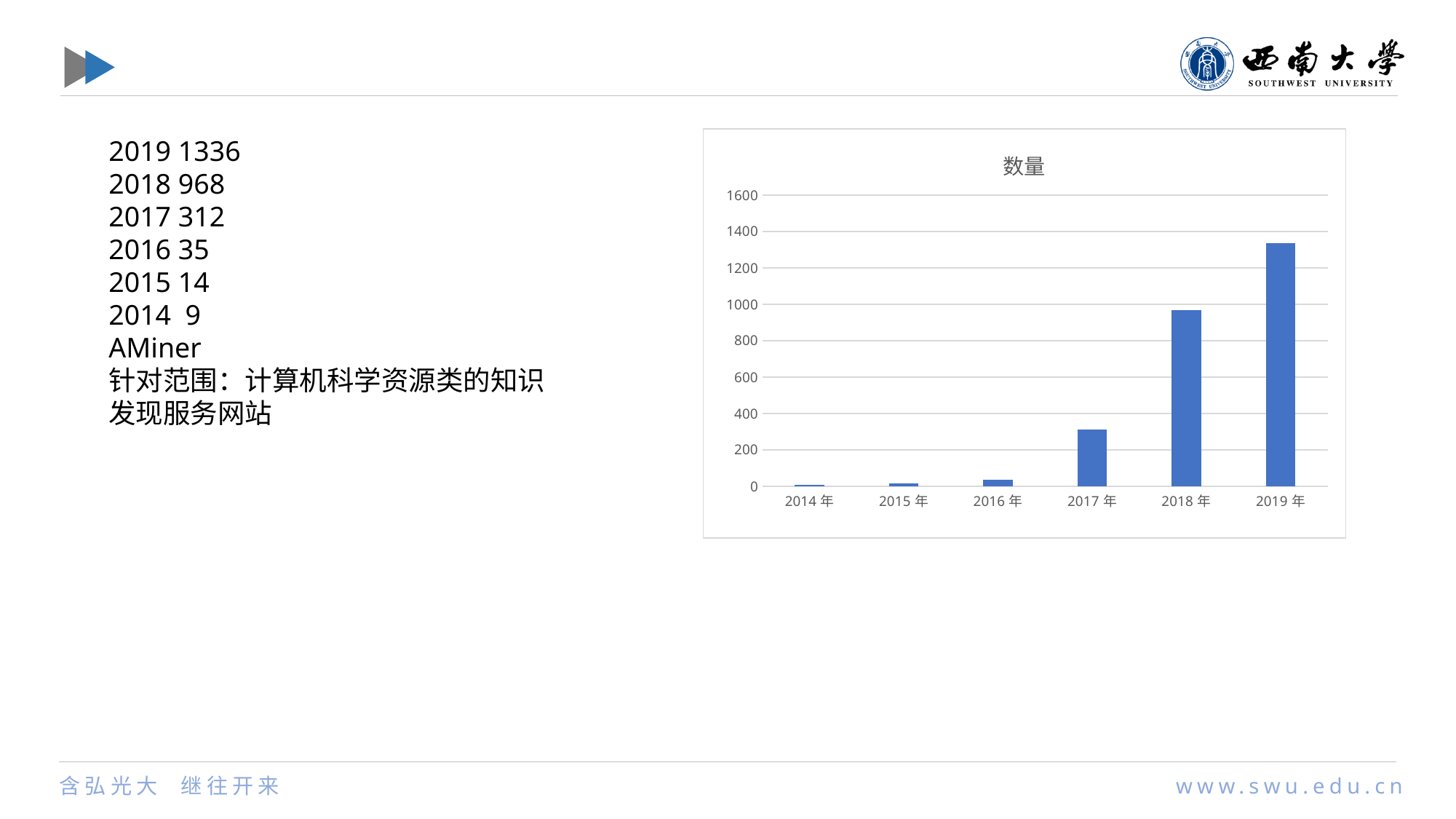
Which year has the highest bar in the chart? 2019 年 What kind of chart is shown on the slide? bar chart Which is larger, the value for 2018 年 or the value for 2017 年? 2018 年 Do the values rise or fall from 2014 年 to 2019 年 along the x axis? rise Which year has the lowest bar in the chart? 2014 年 Is the value for 2018 年 greater or less than 1000? less According to the values listed on the slide, what is the difference between the 2019 value and the 2018 value? 368 Is the value for 2019 年 greater or less than 1200? greater According to the values listed on the slide, what is the value for 2019? 1336 What is the title of the chart? 数量 How many years (categories) are shown on the x axis of the chart? 6 Is the value for 2017 年 greater or less than 400? less